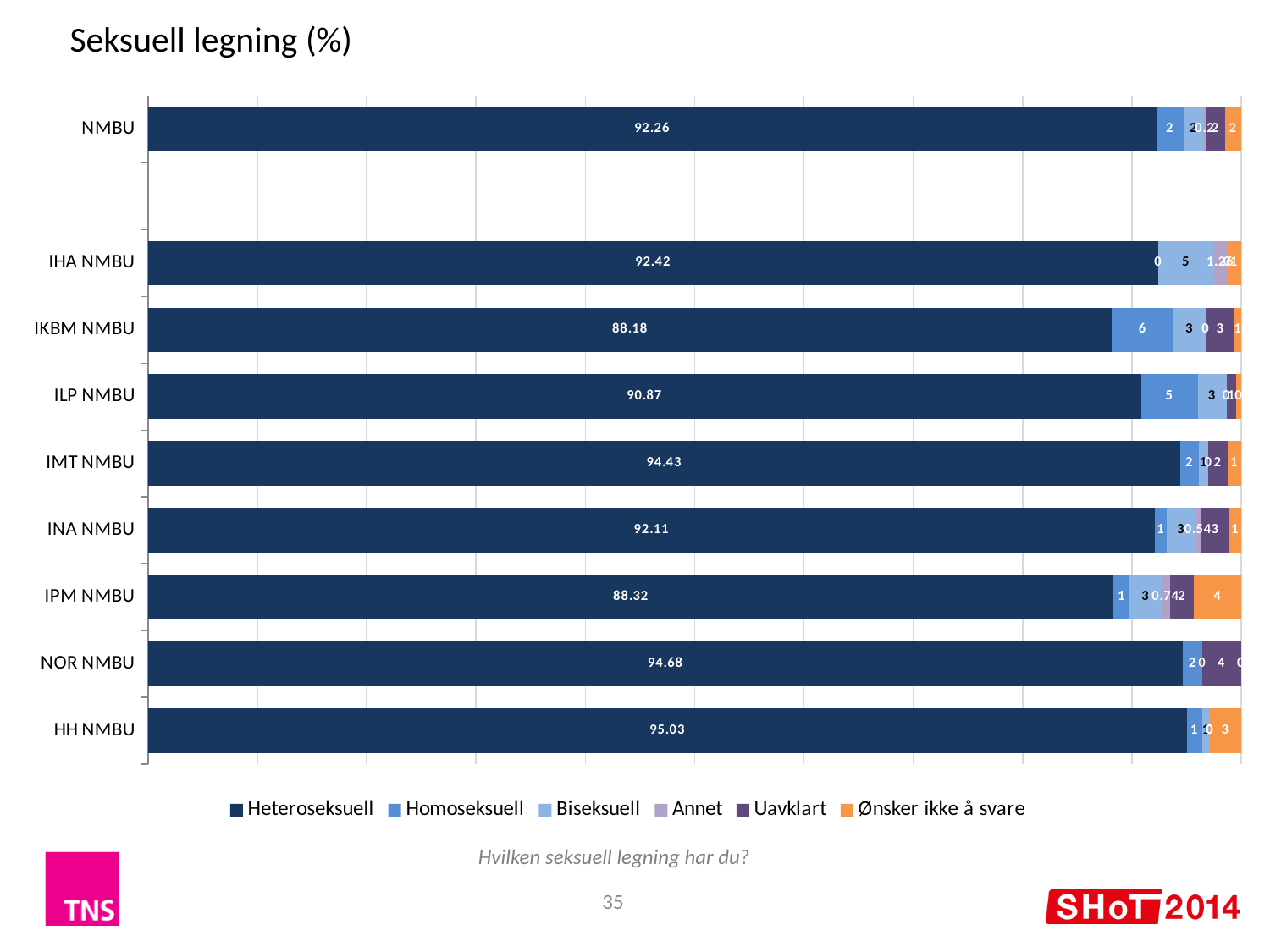
How many series does the legend list? 6 What is the Heteroseksuell value for NMBU? 92.26 What is the Heteroseksuell value for ILP NMBU? 90.87 What is the Heteroseksuell value for HH NMBU? 95.03 Which has a larger Heteroseksuell value, IMT NMBU or NOR NMBU? NOR NMBU Which category has the highest Heteroseksuell value? HH NMBU Which category has the lowest Heteroseksuell value? IKBM NMBU What is the title of the chart? Seksuell legning (%) What is the Heteroseksuell value for IKBM NMBU? 88.18 How many labelled categories are shown on the y axis? 9 What is the difference between the Heteroseksuell values for HH NMBU and IKBM NMBU? 6.85 What type of chart is shown on the slide? Stacked bar chart